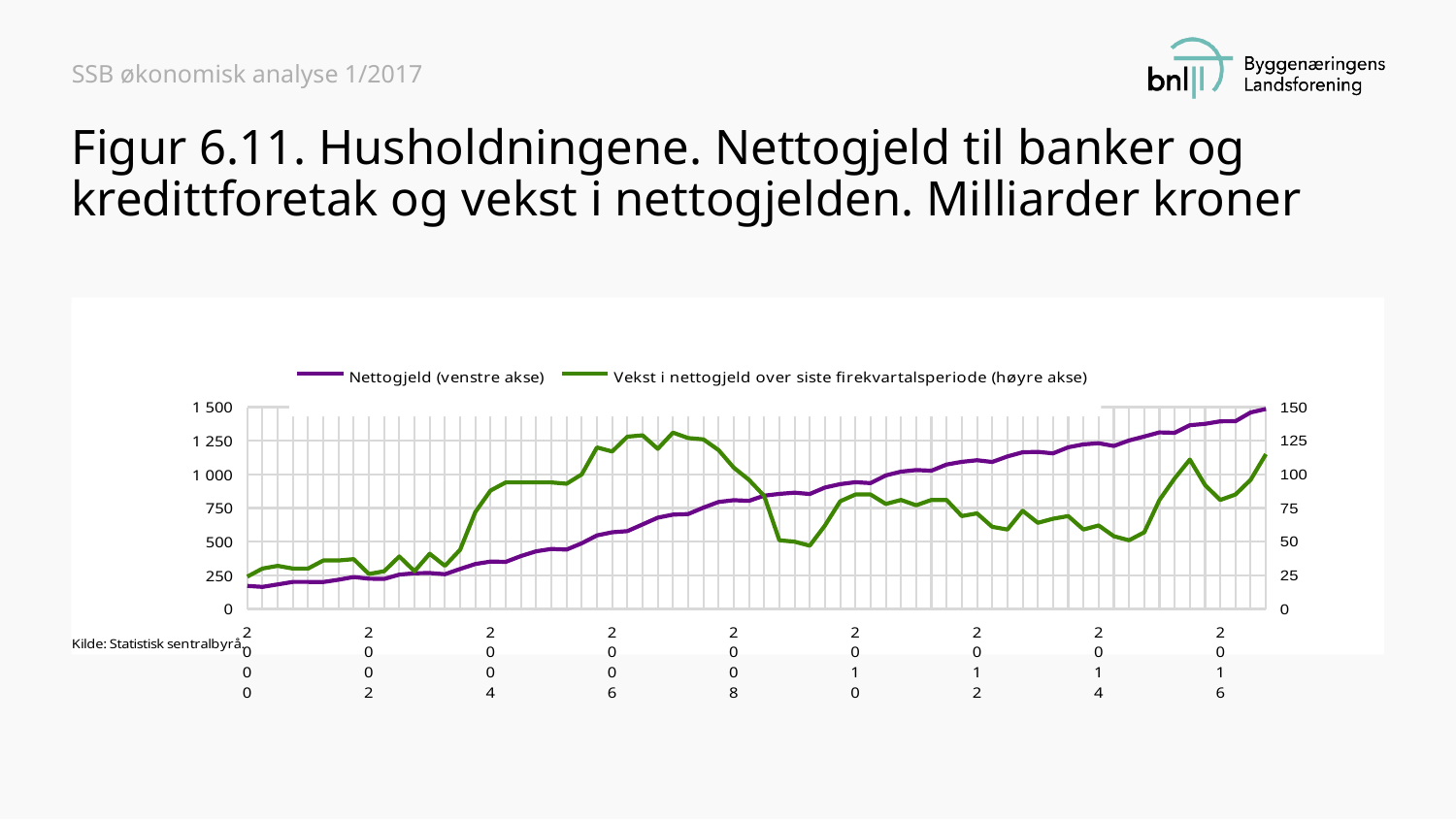
Is the Nettogjeld value in 2000 greater or less than 250? less Does the Nettogjeld series generally rise or fall from 2000 to 2016? Rise How many year labels are shown along the x axis? 9 What is the highest value shown on the right-hand axis? 150 Which series is plotted against the left axis according to the legend? Nettogjeld (venstre akse) Is the value of 'Vekst i nettogjeld over siste firekvartalsperiode' in 2014 greater or less than 75 on the right axis? less What kind of chart is shown on the slide? Line chart Is the Nettogjeld value in 2016 greater or less than 1 250? greater Which is larger for the Nettogjeld series: the value in 2000 or the value in 2016? 2016 How many series does the legend list? 2